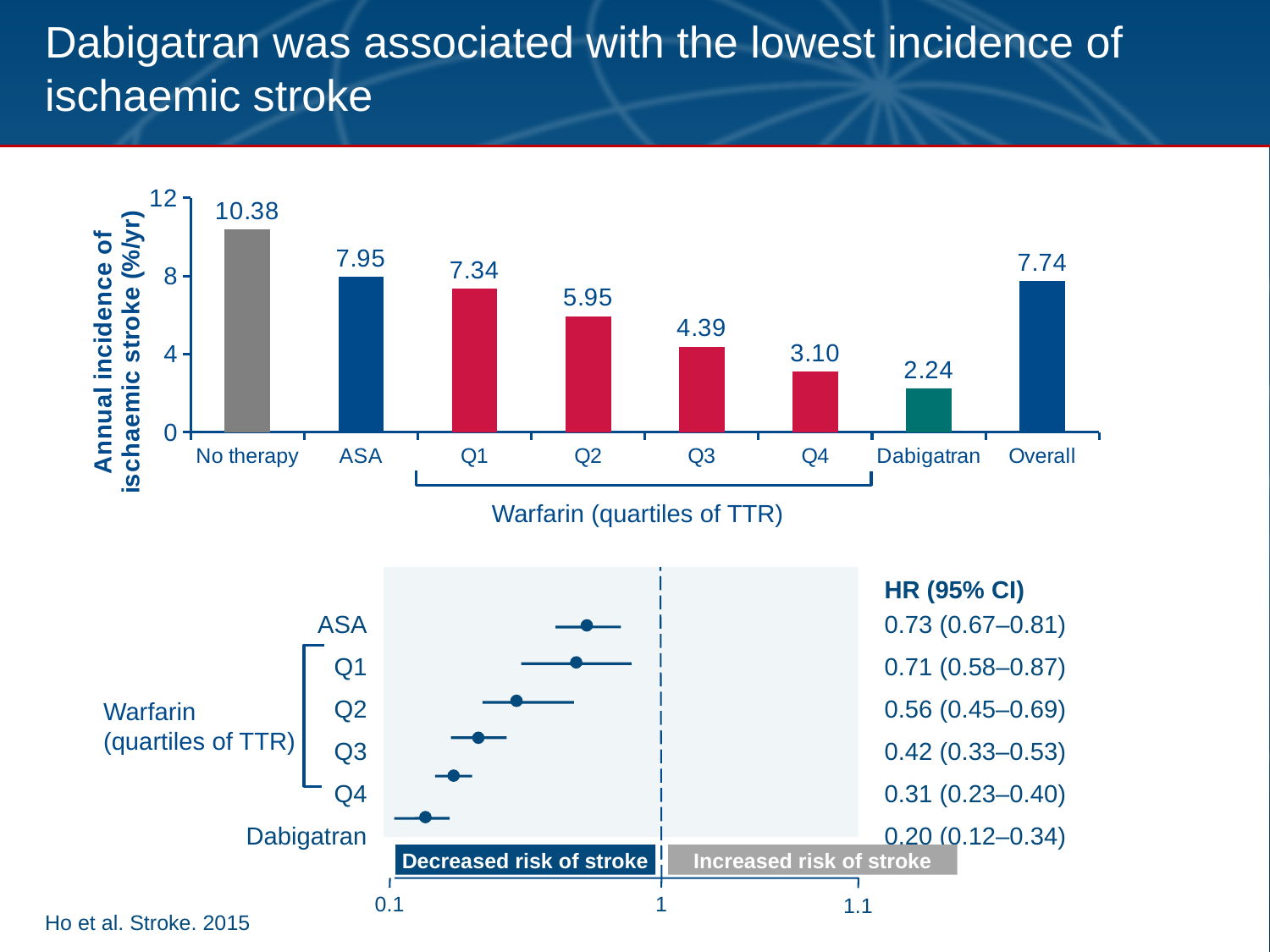
In the top bar chart, which category has the highest annual incidence of ischaemic stroke? No therapy In the top bar chart, how many bars are plotted? 8 In the top bar chart, what is the annual incidence of ischaemic stroke for No therapy? 10.38 What kind of chart is the top chart on the slide? bar chart In the bottom forest plot, what is the HR (95% CI) for Q3? 0.42 (0.33–0.53) In the top bar chart, what is the label of the y axis? Annual incidence of ischaemic stroke (%/yr) In the top bar chart, what is the annual incidence of ischaemic stroke for Dabigatran? 2.24 In the top bar chart, which is larger, the value for Q1 or the value for Q4? Q1 In the top bar chart, which category has the lowest annual incidence of ischaemic stroke? Dabigatran In the bottom forest plot, which treatment has the lowest hazard ratio? Dabigatran In the top bar chart, what is the difference between the values for ASA and Overall? 0.21 In the top bar chart, do the values fall or rise across the warfarin quartiles from Q1 to Q4? fall